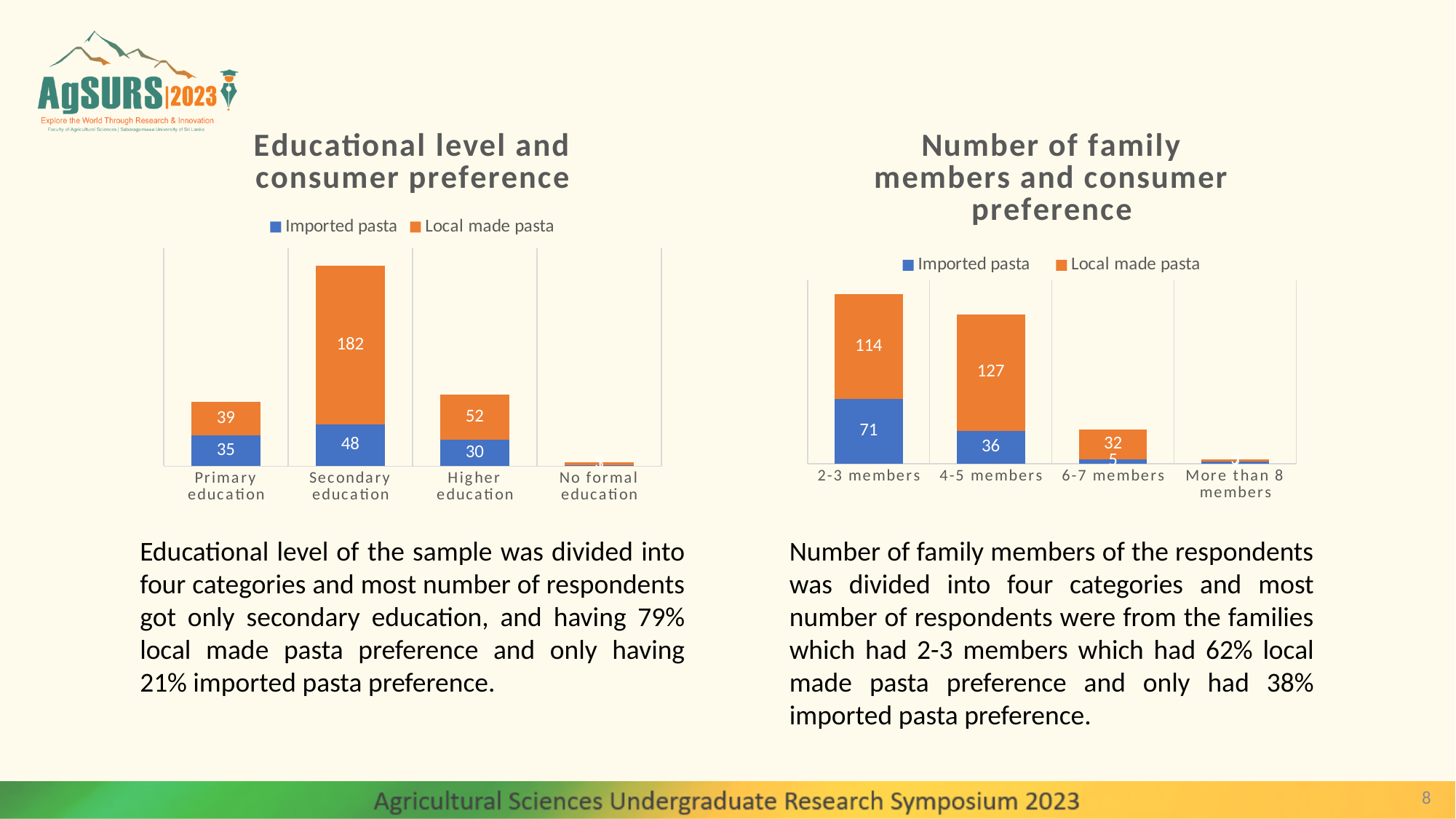
How many categories are shown on the x axis of the 'Number of family members and consumer preference' chart? 4 In the 'Educational level and consumer preference' chart, what is the difference between the Local made pasta and Imported pasta values for Higher education? 22 How many series does the legend list in the 'Educational level and consumer preference' chart? 2 In the 'Number of family members and consumer preference' chart, what is the total of the stacked bar for 2-3 members? 185 In the 'Educational level and consumer preference' chart, what is the Local made pasta value for Secondary education? 182 In the 'Number of family members and consumer preference' chart, what is the Local made pasta value for 4-5 members? 127 In the 'Number of family members and consumer preference' chart, what is the Imported pasta value for 2-3 members? 71 In the 'Educational level and consumer preference' chart, which education category has the highest Local made pasta value? Secondary education In the 'Educational level and consumer preference' chart, what is the total of the stacked bar for Secondary education? 230 In the 'Educational level and consumer preference' chart, what is the Imported pasta value for Primary education? 35 What kind of chart is the 'Number of family members and consumer preference' chart? Stacked bar chart In the 'Number of family members and consumer preference' chart, which is larger: the Local made pasta value for 2-3 members or for 4-5 members? 4-5 members